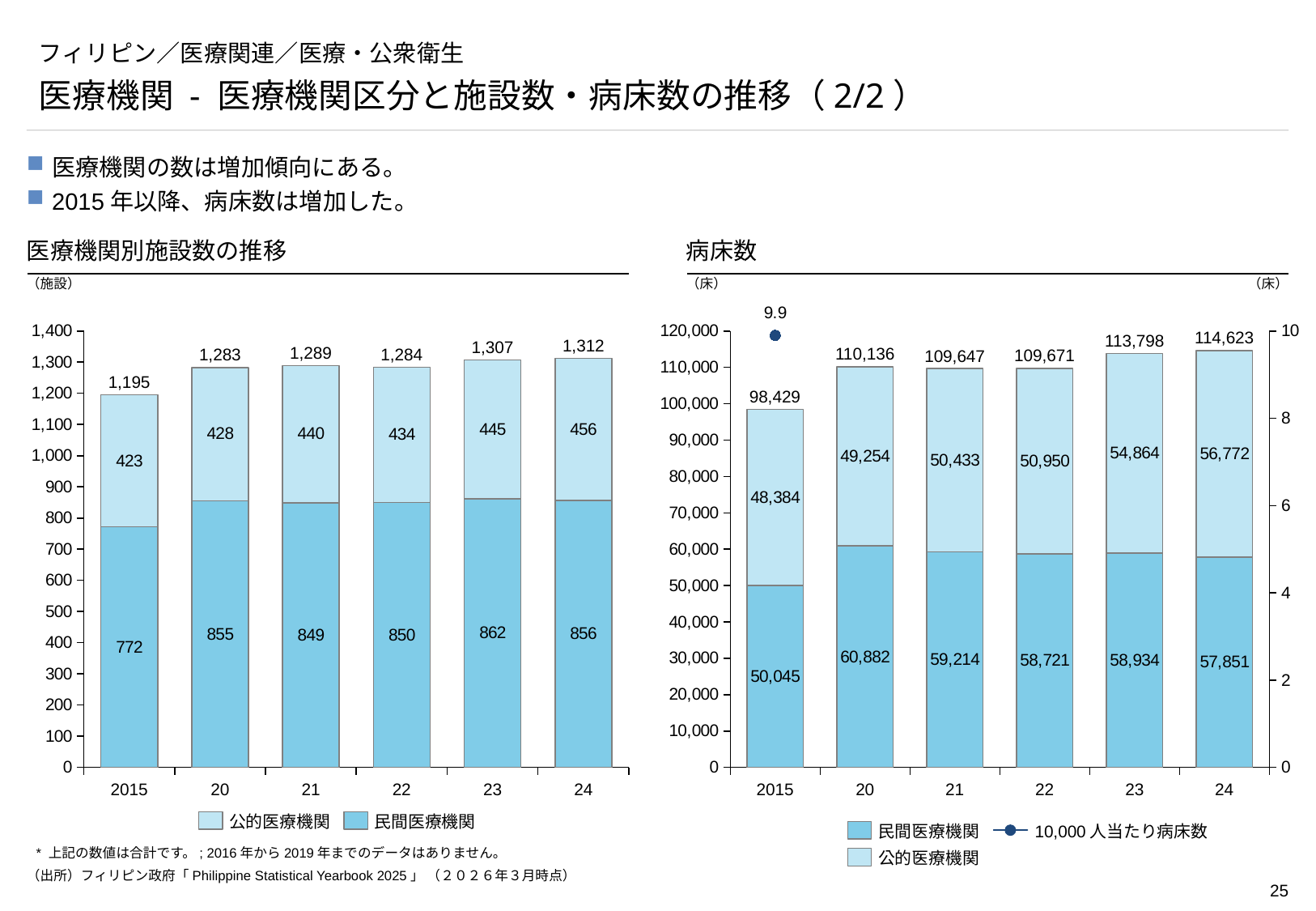
In the 病床数 chart, how many series does the legend list? 3 In the 医療機関別施設数の推移 chart, what is the total shown above the bar for 24? 1,312 In the 病床数 chart, what is the value of 10,000 人当たり病床数 for 2015? 9.9 In the 病床数 chart, what is the difference between the 民間医療機関 values for 20 and 24? 3,031 In the 医療機関別施設数の推移 chart, which is larger in 22: 公的医療機関 or 民間医療機関? 民間医療機関 In the 病床数 chart, what is the value for 公的医療機関 in 23? 54,864 In the 医療機関別施設数の推移 chart, which year has the lowest total? 2015 In the 病床数 chart, which year has the highest total number of beds? 24 In the 医療機関別施設数の推移 chart, what is the value for 民間医療機関 in 2015? 772 What kind of chart is the 医療機関別施設数の推移 chart? Stacked bar chart In the 医療機関別施設数の推移 chart, what is the difference between the 公的医療機関 values for 24 and 2015? 33 In the 医療機関別施設数の推移 chart, how many years are shown on the x axis? 6